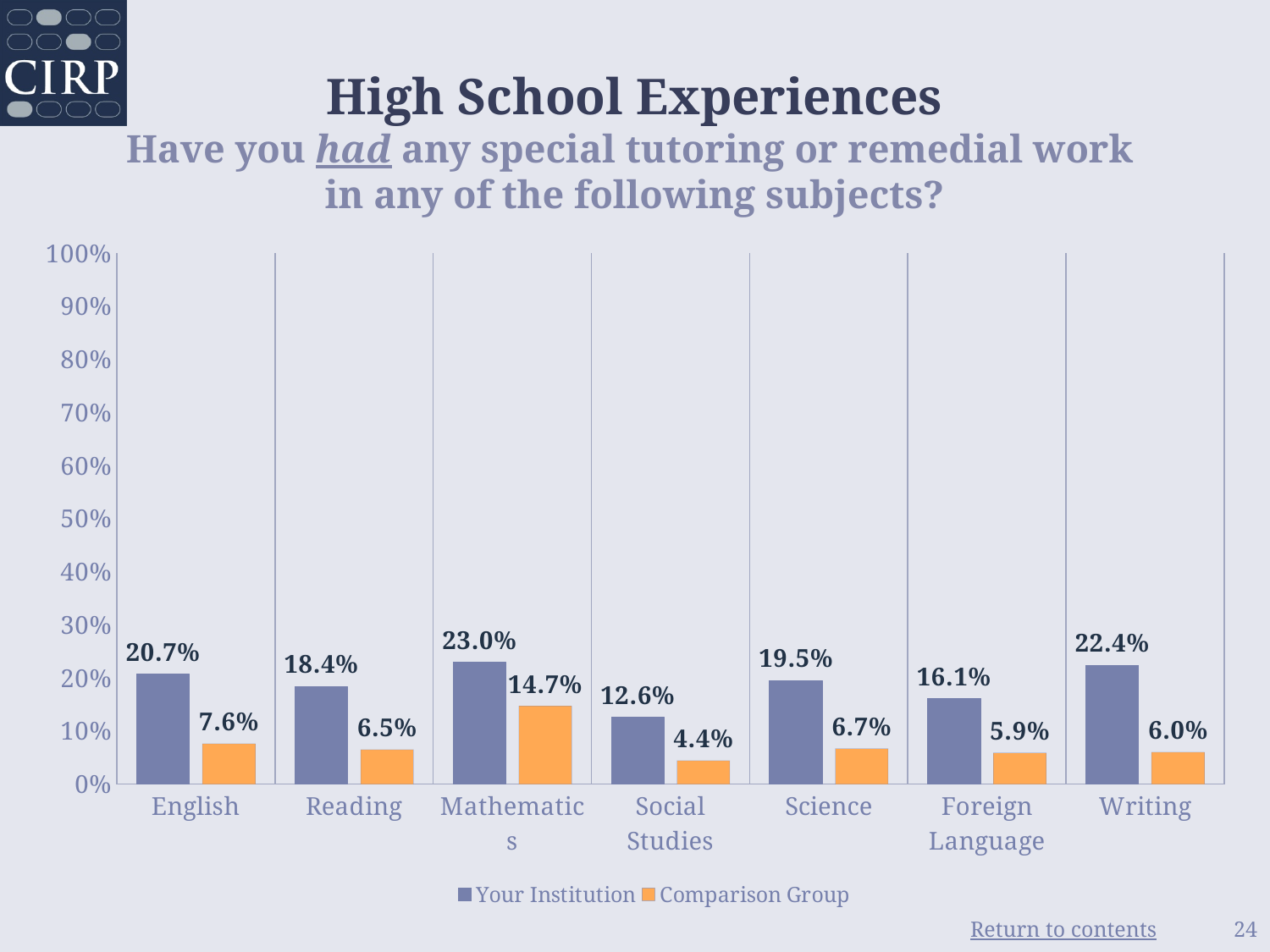
Which subject has the lowest value for the Comparison Group? Social Studies How many series does the legend list? 2 Which subject has the highest value for Your Institution? Mathematics Is the value for Your Institution in Writing greater or less than 20%? greater What colour are the bars for the Comparison Group? orange How many subjects are shown on the x axis? 7 What is the value for Your Institution in Foreign Language? 16.1% What is the difference between Your Institution and the Comparison Group in English? 13.1% What is the value for the Comparison Group in Social Studies? 4.4% Which is larger: the Comparison Group value for Science or for Writing? Science What is the value for Your Institution in Mathematics? 23.0% What kind of chart is shown on the slide? bar chart